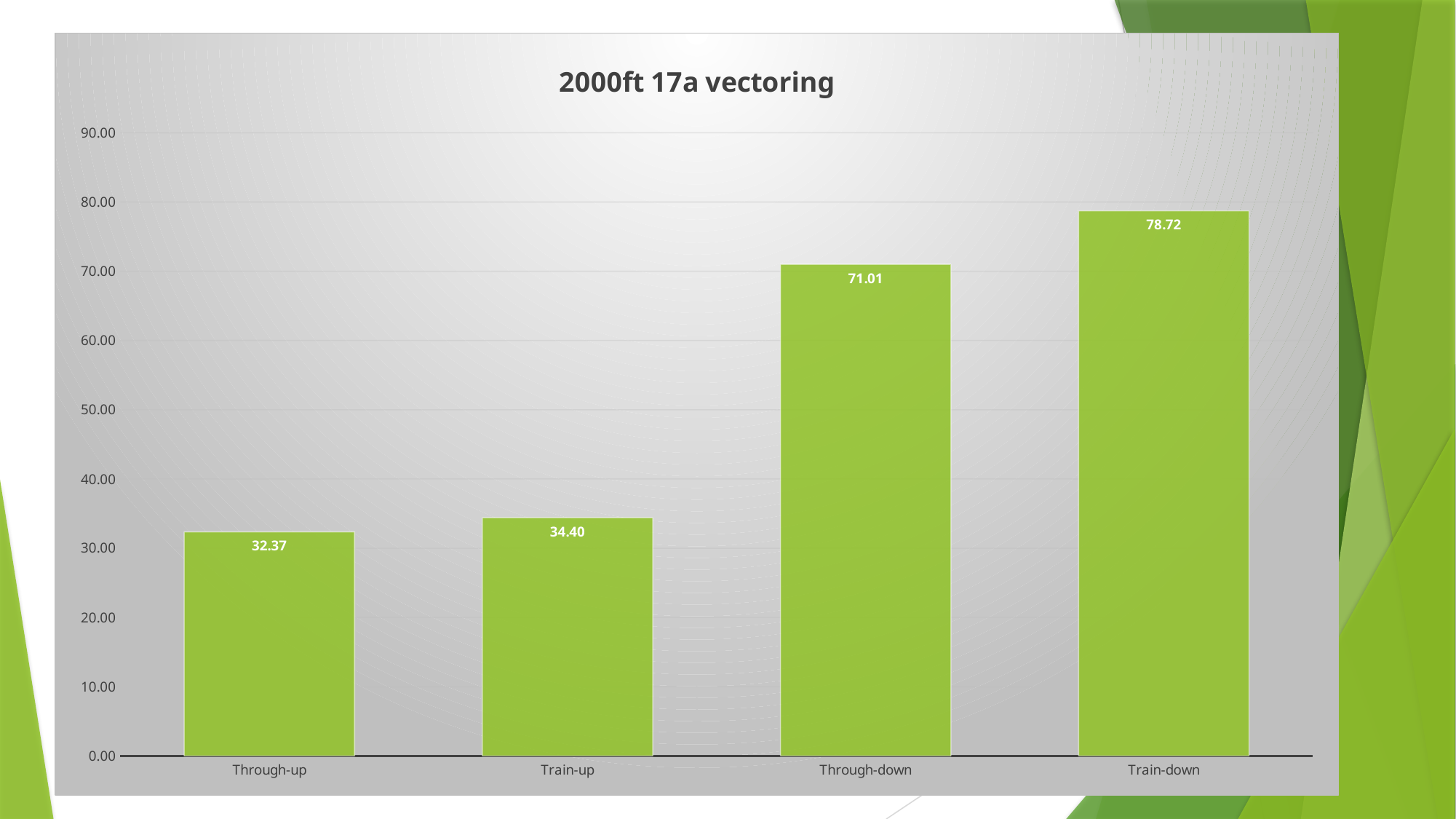
What kind of chart is shown on the slide? bar chart Which category has the lowest value? Through-up What is the title of the chart? 2000ft 17a vectoring Which is larger, the value for Through-down or the value for Train-up? Through-down What is the difference between the values for Train-up and Through-up? 2.03 Which category has the highest value? Train-down What is the difference between the values for Train-down and Through-down? 7.71 What is the value for Through-up? 32.37 How many categories are shown on the x axis? 4 What is the value for Train-down? 78.72 Is the value for Train-up greater or less than 40.00? less What is the value for Through-down? 71.01